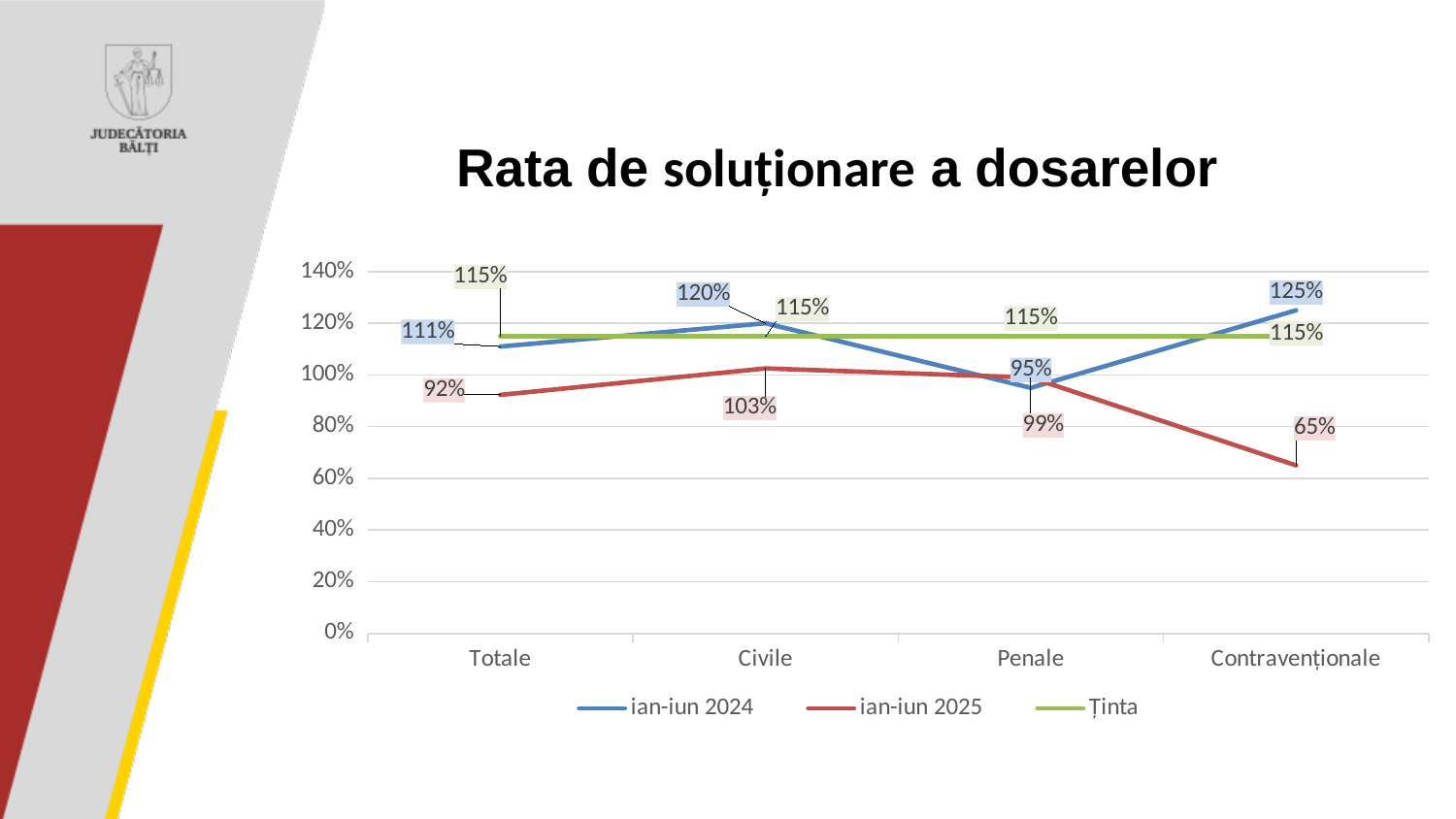
What is the value for ian-iun 2025 in the Contravenționale category? 65% What is the difference between the ian-iun 2024 and ian-iun 2025 values in the Contravenționale category? 60% What is the value of the Ținta series in the Civile category? 115% What is the value for ian-iun 2024 in the Totale category? 111% In the Penale category, which series has the larger value, ian-iun 2024 or ian-iun 2025? ian-iun 2025 Which category has the highest value for ian-iun 2024? Contravenționale How many series does the legend list? 3 Which category has the lowest value for ian-iun 2025? Contravenționale What type of chart is shown on the slide? line chart What is the value for ian-iun 2025 in the Civile category? 103% What is the title of the chart? Rata de soluționare a dosarelor How many categories are shown on the x axis? 4